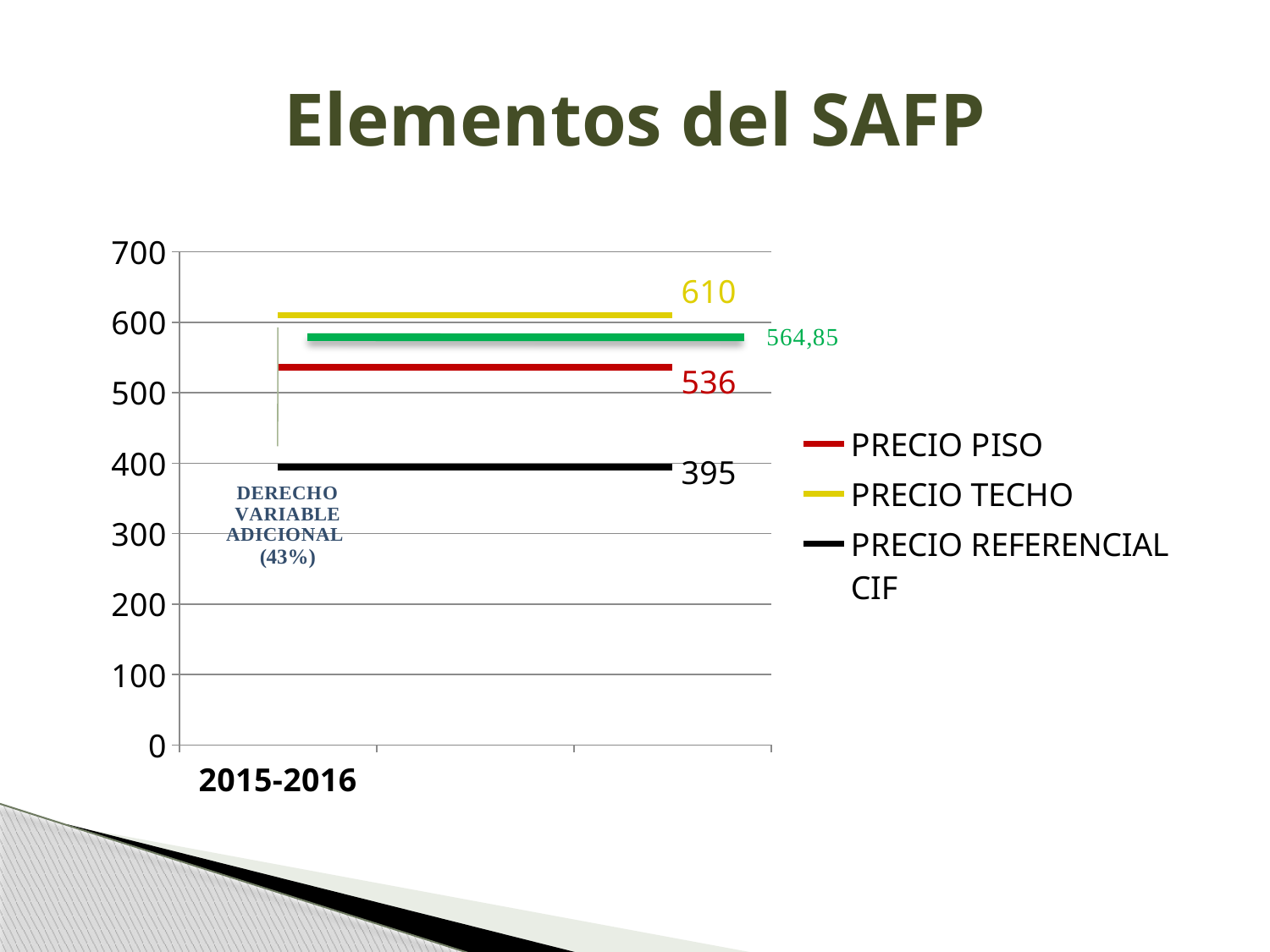
How many series does the legend list? 3 Which is larger, PRECIO PISO or PRECIO REFERENCIAL CIF? PRECIO PISO Which legend series has the lowest value? PRECIO REFERENCIAL CIF What kind of chart is shown on the slide? Line chart What is the value of PRECIO TECHO? 610 What is the value of PRECIO REFERENCIAL CIF? 395 Which legend series has the highest value? PRECIO TECHO What period is labelled on the x axis? 2015-2016 What is the difference between PRECIO TECHO and PRECIO PISO? 74 What is the value of PRECIO PISO? 536 What is the difference between PRECIO PISO and PRECIO REFERENCIAL CIF? 141 What value is labelled on the green line? 564,85